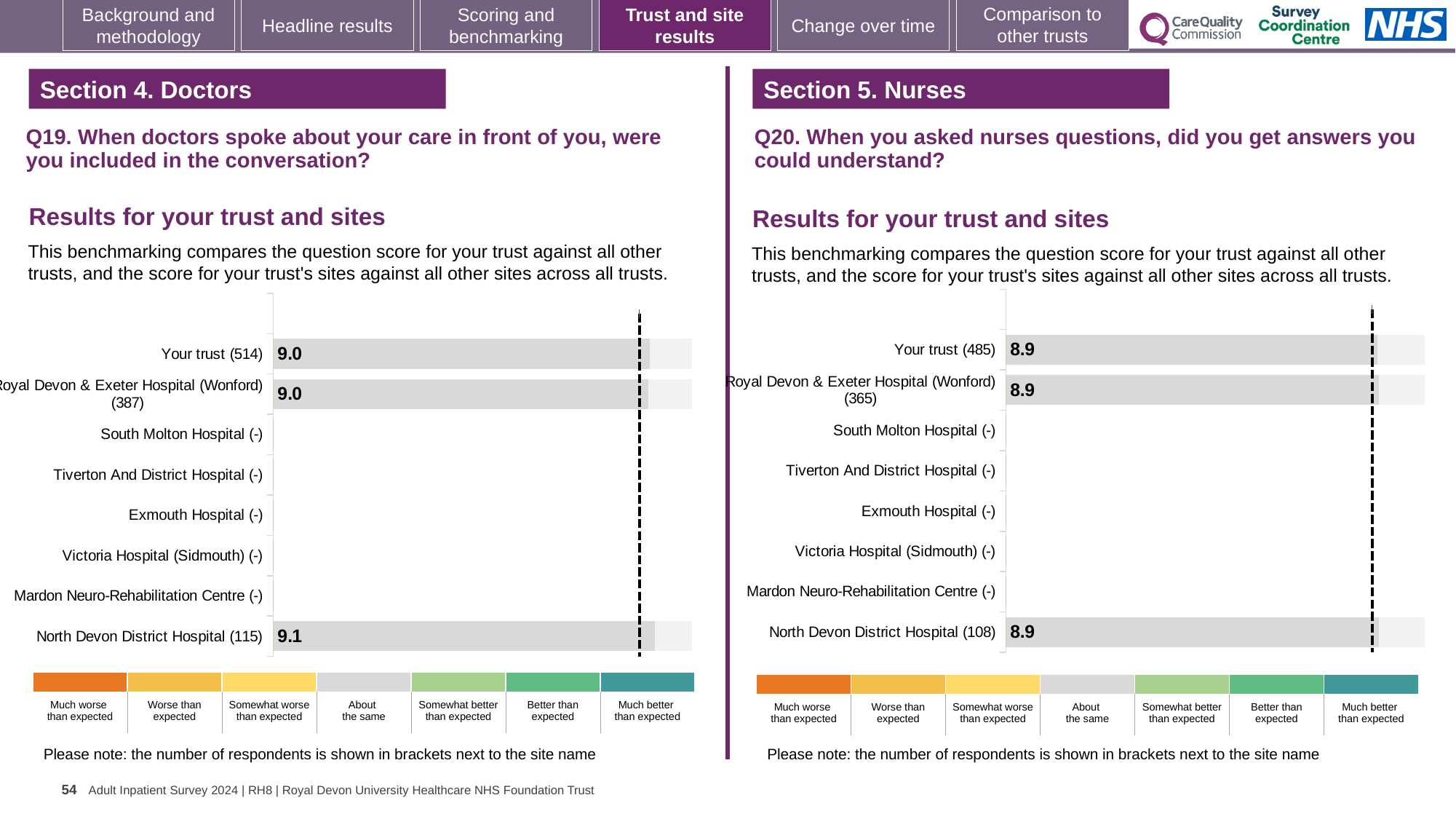
What kind of chart is used on the Q20 chart (right)? Bar chart On the Q19 chart (left), what is the difference between the score for North Devon District Hospital (115) and the score for Your trust (514)? 0.1 Which is larger: the Your trust score on the Q19 chart (left) or the Your trust score on the Q20 chart (right)? Q19 (9.0) How many site/trust categories are listed on the Q19 chart (left)? 8 On the Q20 chart (right), what is the score for North Devon District Hospital (108)? 8.9 On the Q19 chart (left), how many sites have a score bar shown? 3 On the Q19 chart (left), what is the score for North Devon District Hospital (115)? 9.1 On the Q20 chart (right), what is the difference between the score for Your trust (485) and the score for Royal Devon & Exeter Hospital (Wonford) (365)? 0.0 On the Q19 chart (left), what is the score for Royal Devon & Exeter Hospital (Wonford) (387)? 9.0 On the Q20 chart (right), what is the score for Your trust (485)? 8.9 On the Q19 chart (left), which site with a printed score has the highest value? North Devon District Hospital (115) On the Q19 chart (left), what is the score for Your trust (514)? 9.0